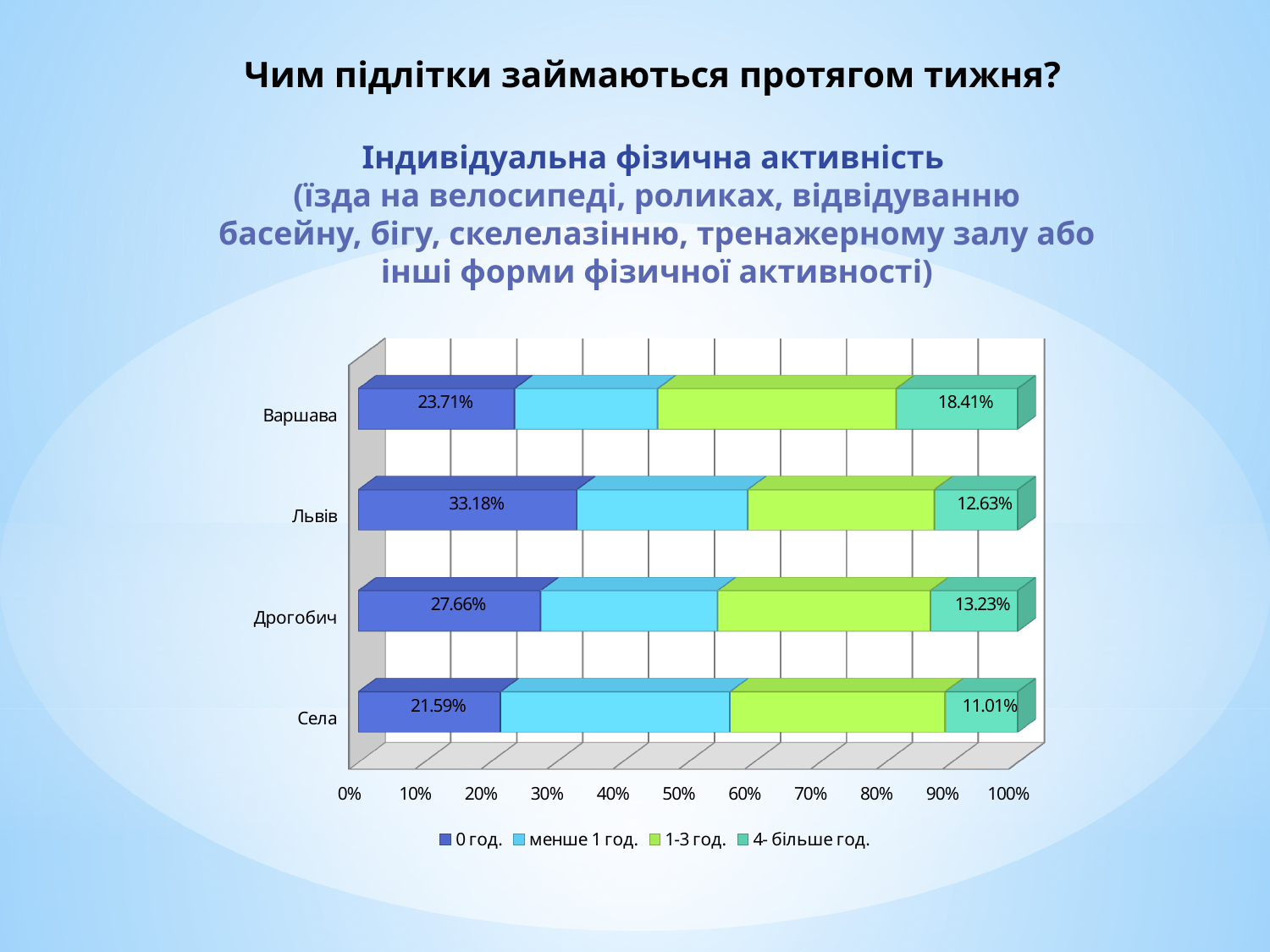
What is the value of the "4- більше год." series for Дрогобич? 13.23% How many series does the legend list? 4 What kind of chart is shown on the slide? stacked bar chart Which series is shown in the lightest green colour in the legend? 1-3 год. Which location has the lowest value for the "4- більше год." series? Села What is the value of the "0 год." series for Села? 21.59% Which is larger: the "4- більше год." value for Варшава or for Львів? Варшава What is the value of the "0 год." series for Львів? 33.18% What is the value of the "4- більше год." series for Варшава? 18.41% How many categories (locations) are shown on the chart? 4 What is the difference between the "0 год." values for Львів and Села? 11.59% Which location has the highest value for the "0 год." series? Львів